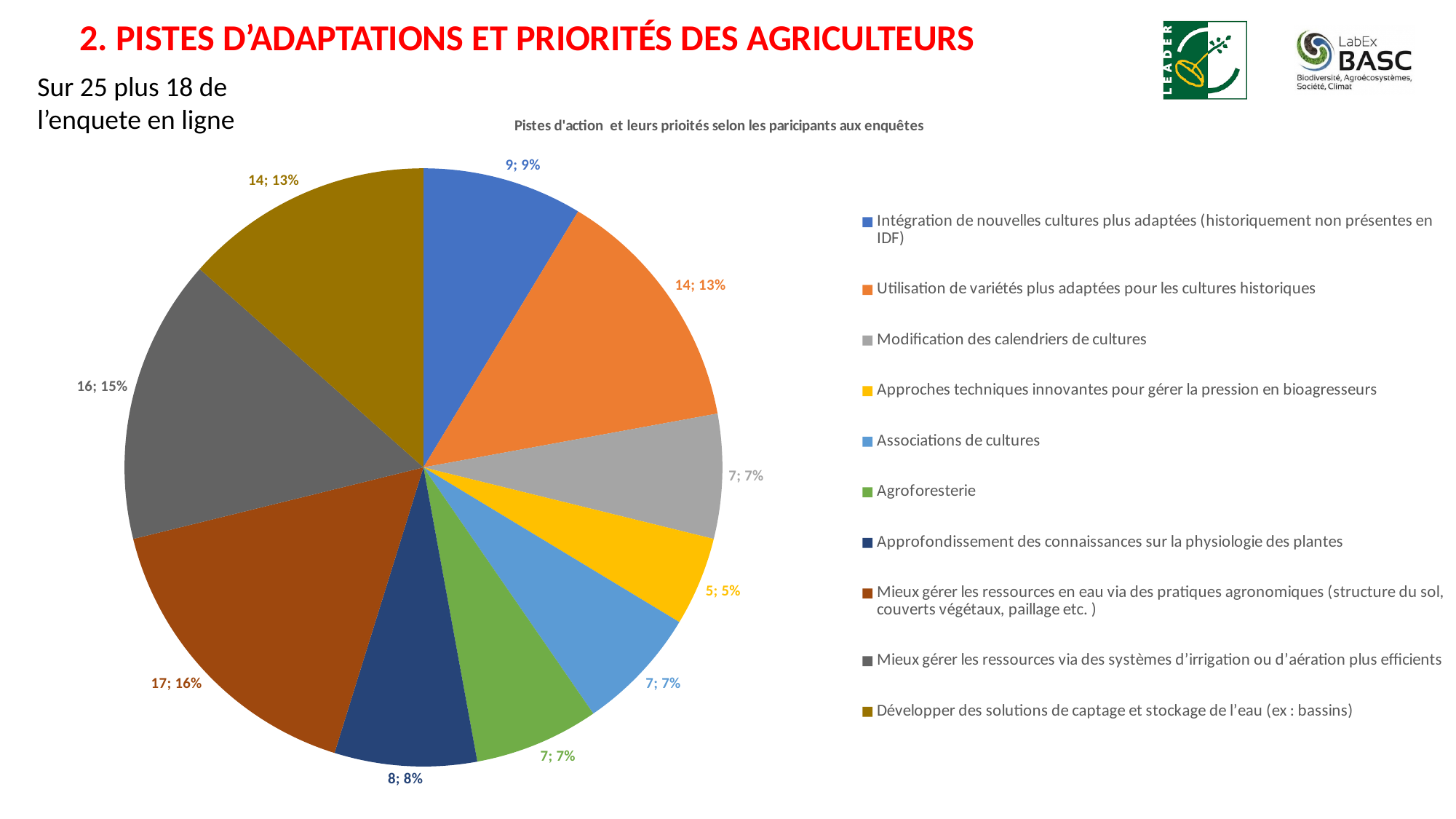
Which has a larger count: 'Utilisation de variétés plus adaptées pour les cultures historiques' or 'Intégration de nouvelles cultures plus adaptées'? Utilisation de variétés plus adaptées pour les cultures historiques Which category has the largest slice of the pie? Mieux gérer les ressources en eau via des pratiques agronomiques (structure du sol, couverts végétaux, paillage etc. ) What percentage share does 'Approches techniques innovantes pour gérer la pression en bioagresseurs' have? 5% How many slices does the pie chart have? 10 What is the count shown for 'Approfondissement des connaissances sur la physiologie des plantes'? 8 What percentage share does 'Mieux gérer les ressources via des systèmes d'irrigation ou d'aération plus efficients' have? 15% Which category has the smallest slice of the pie? Approches techniques innovantes pour gérer la pression en bioagresseurs What colour is the slice for 'Développer des solutions de captage et stockage de l'eau (ex : bassins)'? dark gold What is the title of the pie chart? Pistes d'action et leurs prioités selon les paricipants aux enquêtes What is the data label for the 'Agroforesterie' slice? 7; 7% What kind of chart is shown on the slide? pie chart What is the difference in count between 'Mieux gérer les ressources en eau via des pratiques agronomiques' and 'Intégration de nouvelles cultures plus adaptées'? 8